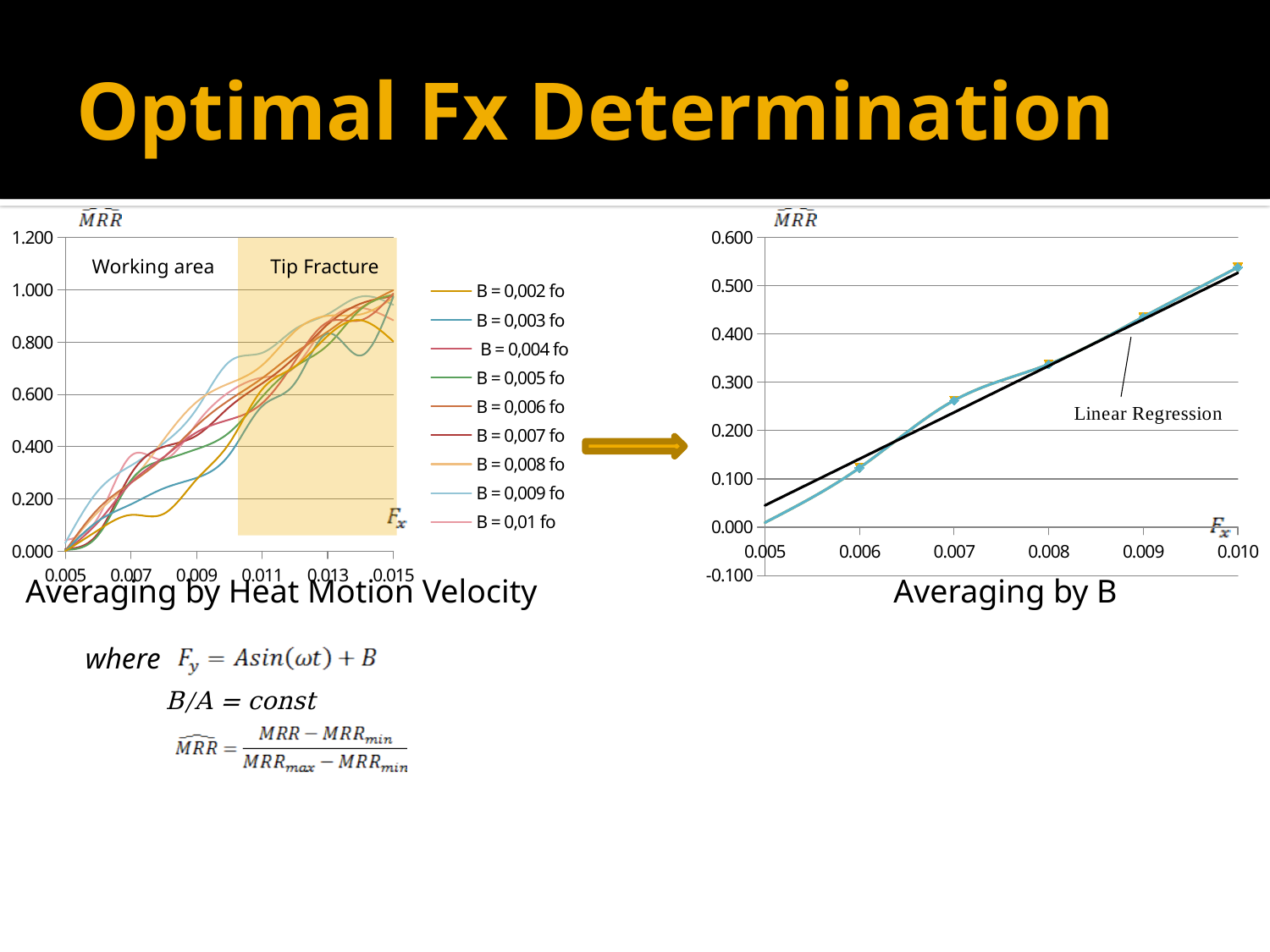
What kind of chart is the 'Averaging by B' chart on the right? line chart What kind of chart is the 'Averaging by Heat Motion Velocity' chart on the left? line chart In the left chart ('Averaging by Heat Motion Velocity'), what are the two labelled regions of the plot area? Working area and Tip Fracture In the right chart ('Averaging by B'), at which Fx value is the MRR highest? 0.010 In the right chart ('Averaging by B'), which is larger: the value at Fx = 0.008 or the value at Fx = 0.006? 0.008 In the right chart ('Averaging by B'), is the value at Fx = 0.007 greater or less than 0.300? less In the right chart ('Averaging by B'), is the value at Fx = 0.010 greater or less than 0.500? greater In the left chart ('Averaging by Heat Motion Velocity'), do the MRR values generally rise or fall as Fx increases? rise How many series does the legend of the left chart ('Averaging by Heat Motion Velocity') list? 9 In the right chart ('Averaging by B'), is the value at Fx = 0.009 greater or less than 0.400? greater In the left chart ('Averaging by Heat Motion Velocity'), what is the highest value shown on the vertical axis? 1.200 In the right chart ('Averaging by B'), how many data points are plotted? 6